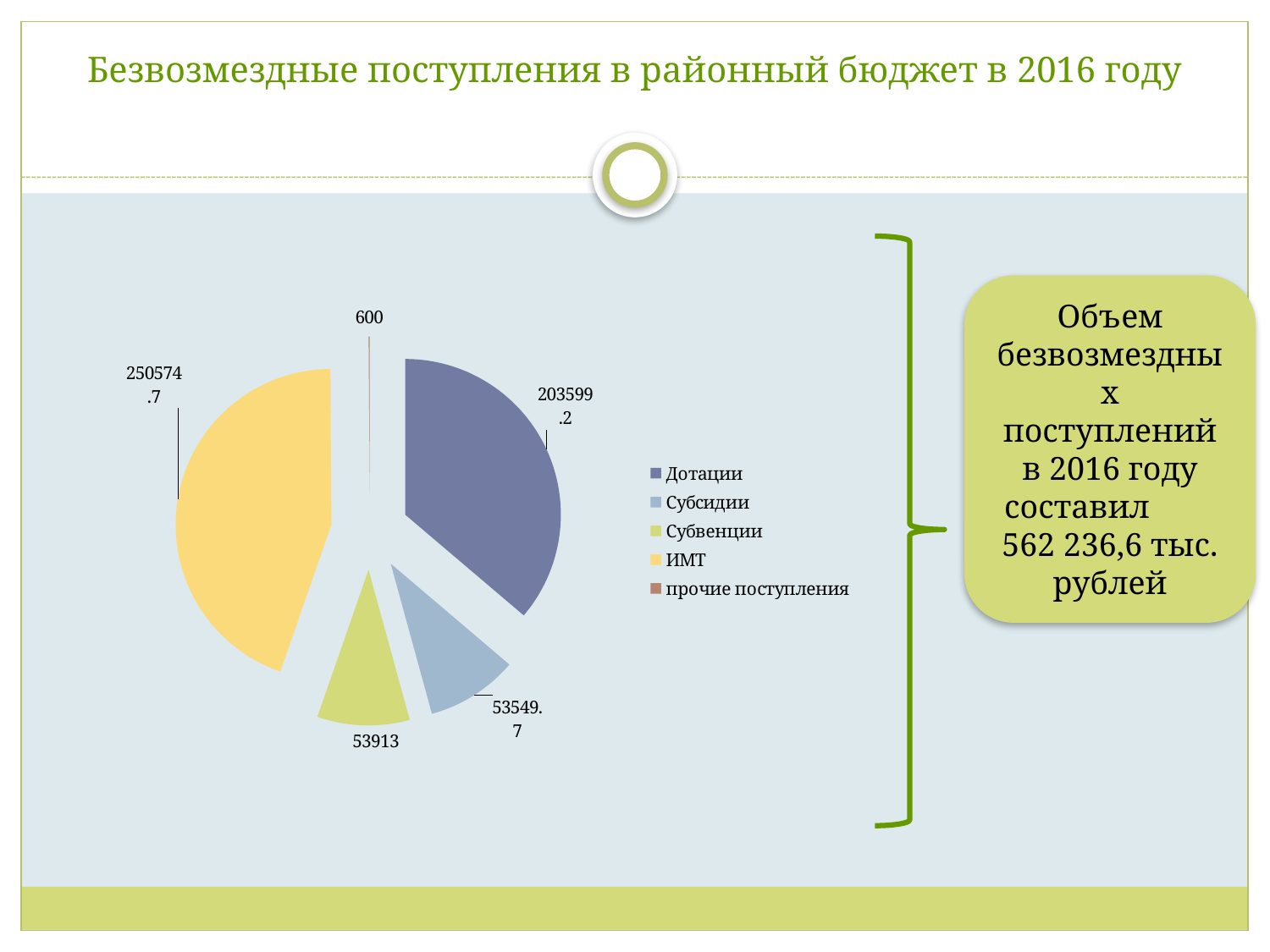
What is the value for ИМТ? 250574.7 What kind of chart is shown on the slide? pie chart What is the value for Дотации? 203599.2 How many categories does the pie chart show? 5 What is the title of the slide containing the chart? Безвозмездные поступления в районный бюджет в 2016 году What is the difference between the values for ИМТ and Дотации? 46975.5 What is the value for Субсидии? 53549.7 Which category has the largest slice of the pie? ИМТ What is the value for Субвенции? 53913 Which is larger, the value for ИМТ or the value for Дотации? ИМТ Which category has the smallest slice of the pie? прочие поступления What is the value for прочие поступления? 600